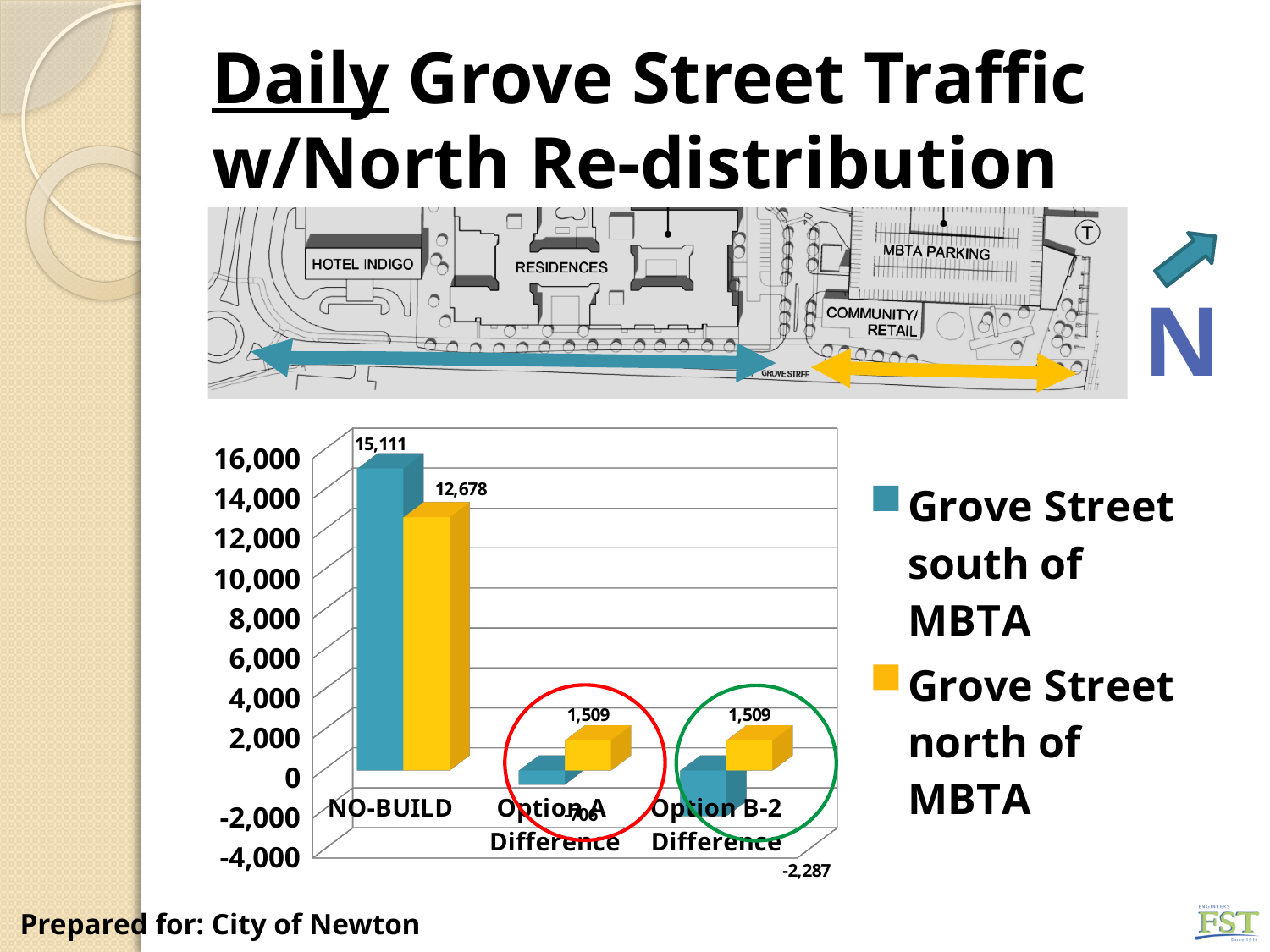
What is the difference between the Grove Street south of MBTA and Grove Street north of MBTA values in the NO-BUILD category? 2,433 Is the value for Grove Street south of MBTA in the Option A Difference category greater or less than 0? less Which category has the lowest value for Grove Street south of MBTA? Option B-2 Difference Which category has the highest value for Grove Street north of MBTA? NO-BUILD What kind of chart is shown on the slide? bar chart What is the value for Grove Street north of MBTA in the Option B-2 Difference category? 1,509 How many categories are shown on the x axis of the chart? 3 What is the value for Grove Street south of MBTA in the Option B-2 Difference category? -2,287 In the NO-BUILD category, which series has the larger value: Grove Street south of MBTA or Grove Street north of MBTA? Grove Street south of MBTA How many series does the chart legend list? 2 What is the value for Grove Street south of MBTA in the NO-BUILD category? 15,111 What is the value for Grove Street north of MBTA in the NO-BUILD category? 12,678